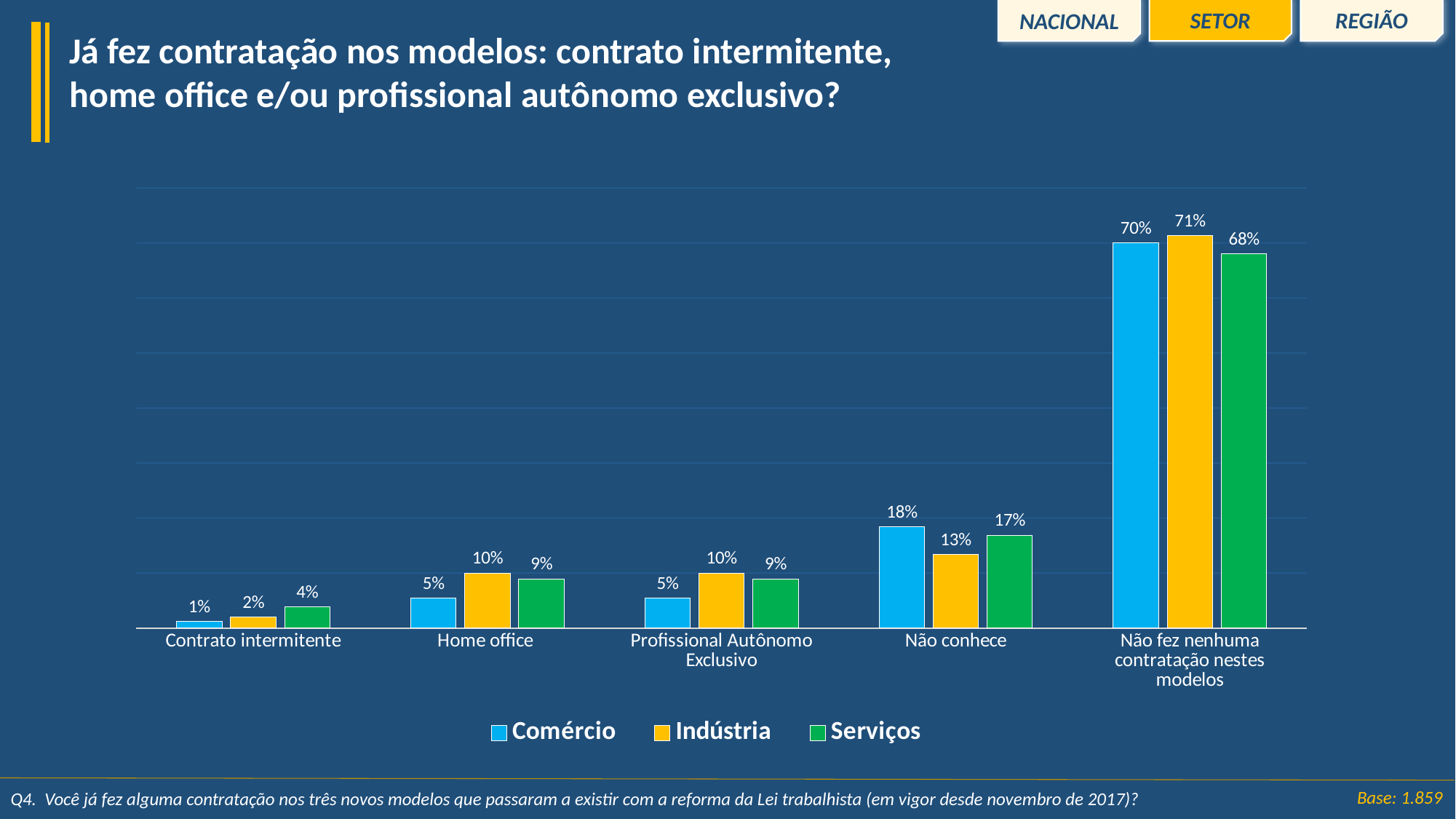
Which category has the highest values across all three series? Não fez nenhuma contratação nestes modelos What is the value for Indústria in the 'Não conhece' category? 13% Which series has the lowest value in the 'Contrato intermitente' category? Comércio How many series does the legend list? 3 What colour represents the Serviços series in the legend? Green Which is larger in the 'Home office' category: Indústria or Serviços? Indústria What is the value for Comércio in the 'Home office' category? 5% What is the difference between the Comércio and Indústria values in the 'Não conhece' category? 5% What is the value for Serviços in the 'Contrato intermitente' category? 4% What kind of chart is shown on the slide? Bar chart Which series has the highest value in the 'Não fez nenhuma contratação nestes modelos' category? Indústria How many categories are shown on the x axis? 5